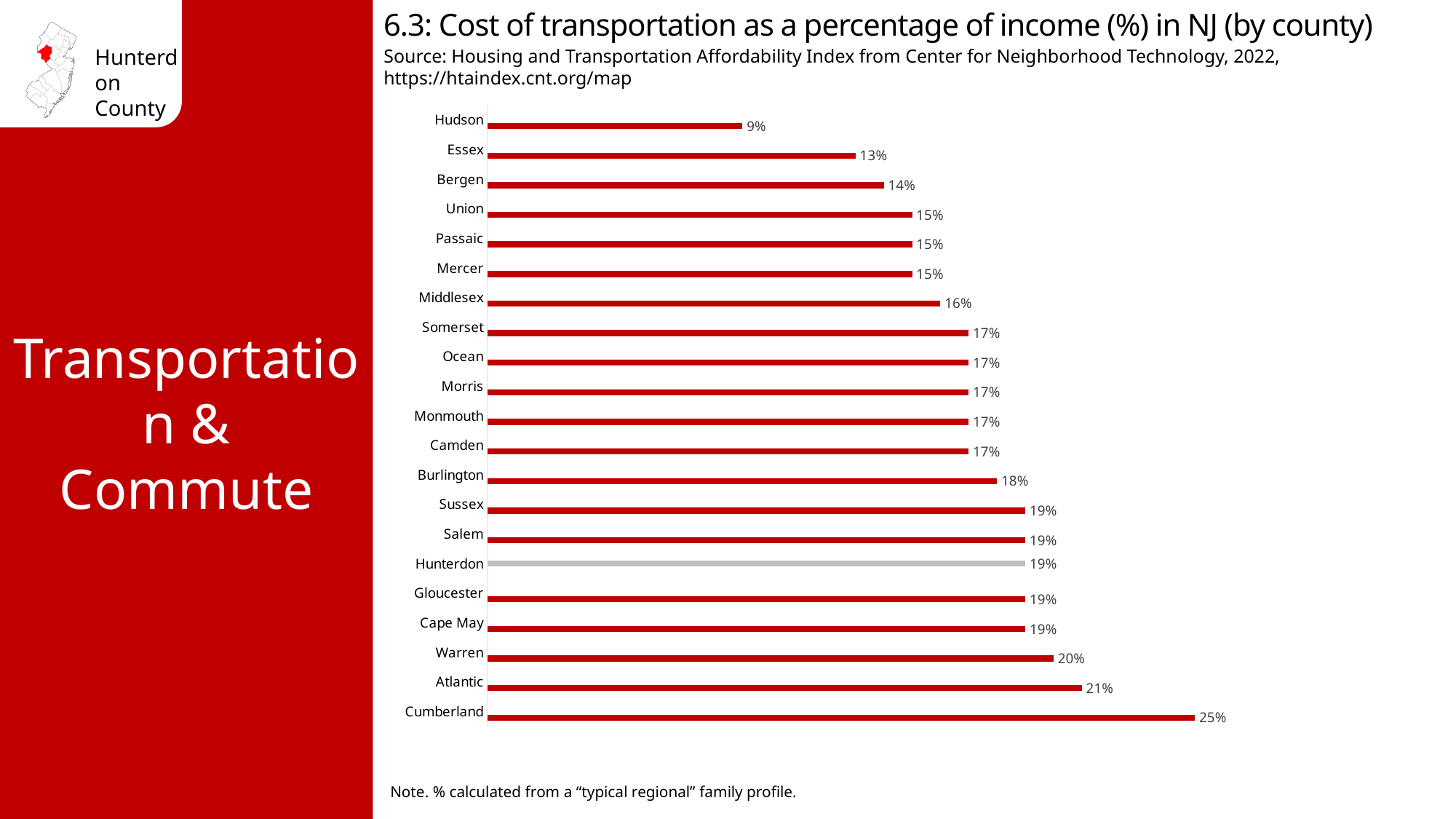
Which county has the highest cost of transportation as a percentage of income? Cumberland Which county has the lowest cost of transportation as a percentage of income? Hudson What is the cost of transportation as a percentage of income for Hunterdon County? 19% What is the difference between the values for Cumberland and Hudson? 16% Which has a higher value, Essex or Burlington? Burlington Which county's bar is shown in grey rather than red? Hunterdon What is the cost of transportation as a percentage of income for Hudson County? 9% Which has a higher value, Bergen or Atlantic? Atlantic What is the value shown for Middlesex County? 16% How many counties are shown in the chart? 21 What kind of chart is shown on the slide? Bar chart What is the difference between the values for Atlantic and Warren? 1%